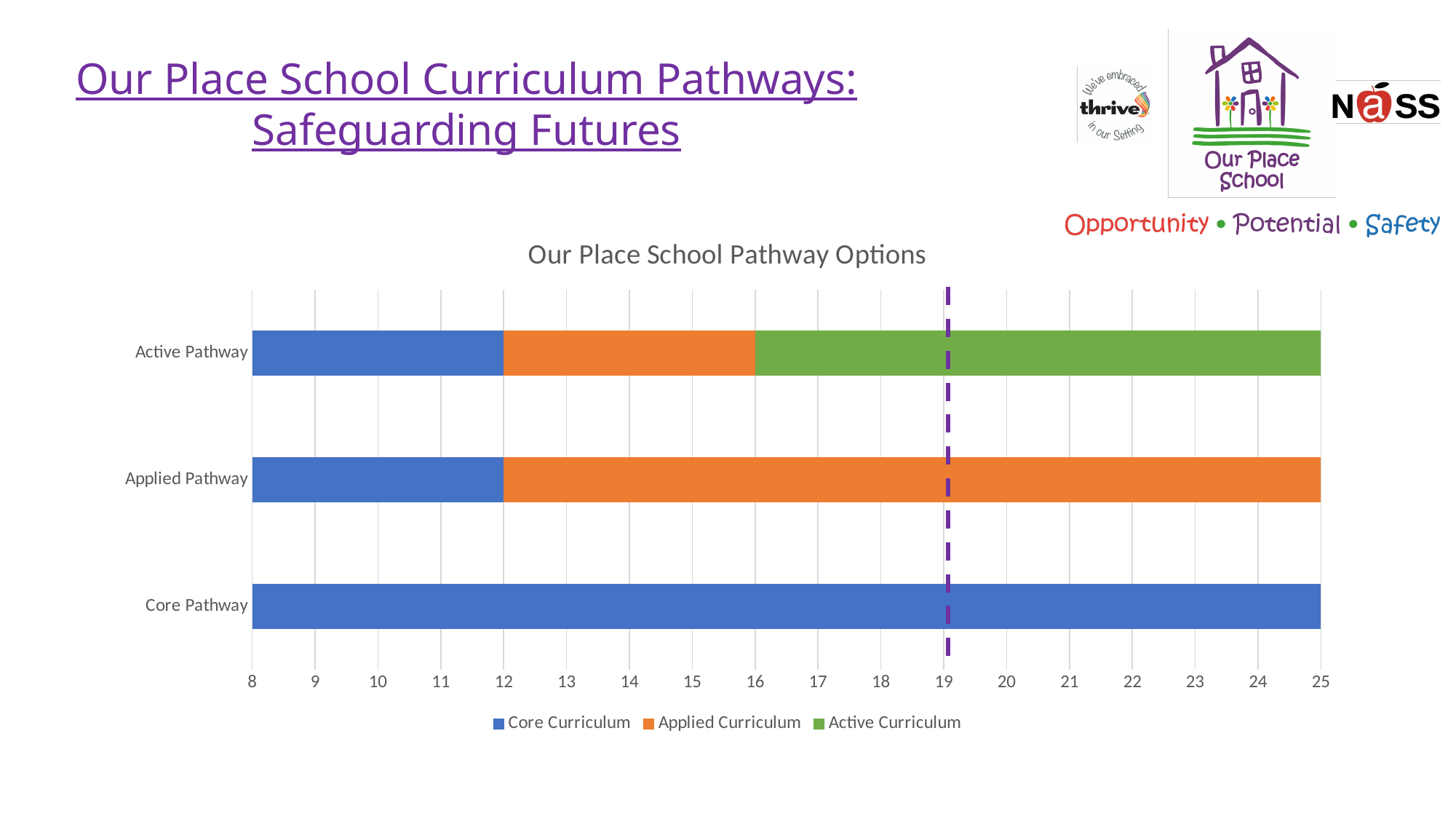
Is the end of the Applied Curriculum segment in the Active Pathway bar greater or less than 18? less At what value on the x axis does the Core Curriculum segment of the Active Pathway bar end? 12 Which pathway has the longer Applied Curriculum segment, the Applied Pathway or the Active Pathway? Applied Pathway How many series does the legend list? 3 How many pathways (categories) are plotted on the chart? 3 What is the title of the chart? Our Place School Pathway Options At what value on the x axis does the Core Pathway bar end? 25 At what value on the x axis does the Applied Curriculum segment of the Active Pathway bar end? 16 What type of chart is shown on the slide? bar chart Which colour represents the Active Curriculum in the legend? green How many curriculum series appear in the Core Pathway bar? 1 At what value on the x axis does the Core Curriculum segment of the Applied Pathway bar end? 12